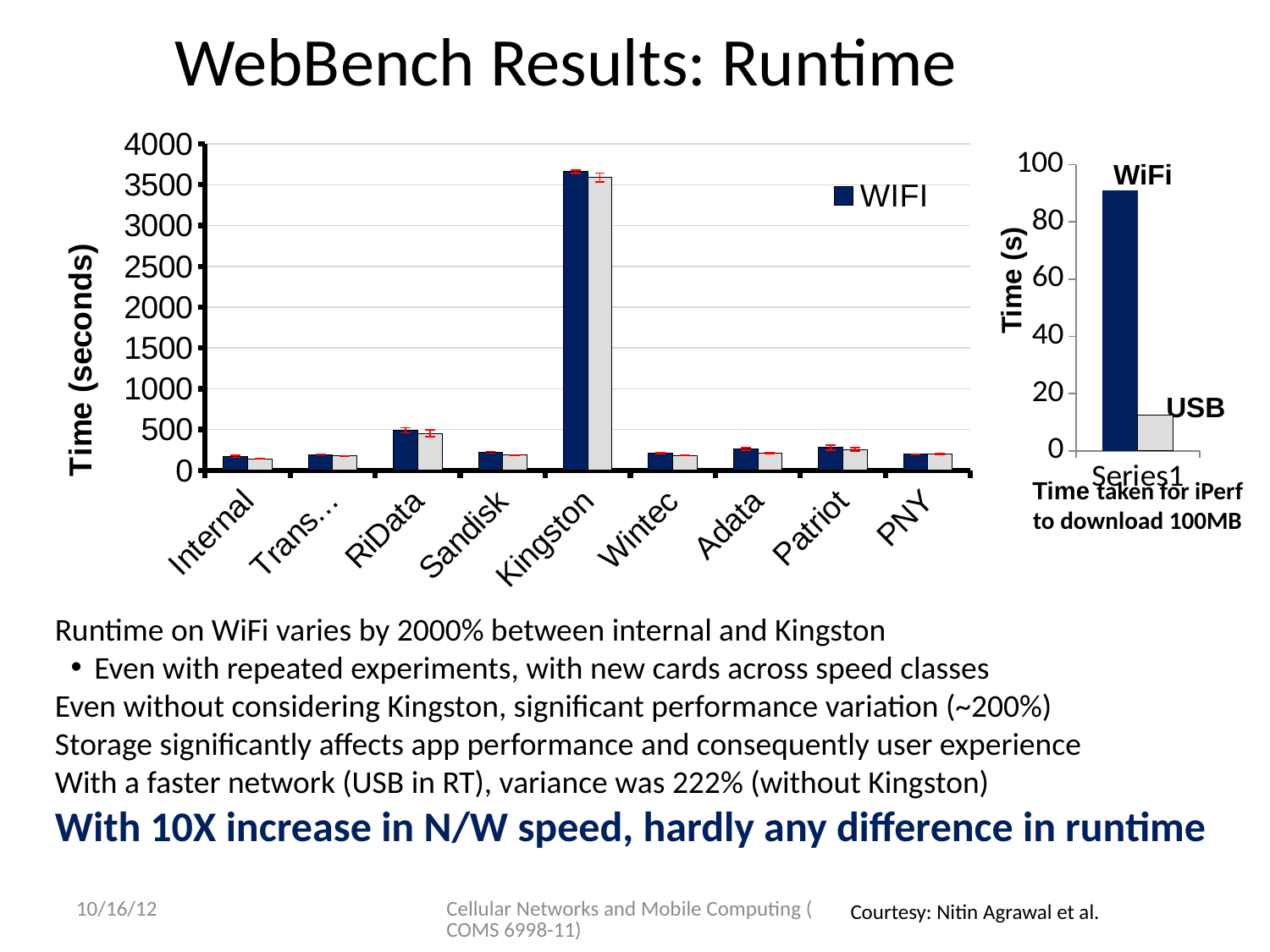
In the left chart, is the WIFI value for Kingston greater or less than 3500? greater What kind of chart is the left chart? bar chart In the right chart (Time taken for iPerf to download 100MB), is the value for WiFi greater or less than 80? greater In the left chart, which category has the highest runtime? Kingston In the left chart, is the WIFI value for Internal greater or less than 500? less In the left chart, which has a larger WIFI runtime, RiData or Sandisk? RiData How many series does the legend of the left chart list? 1 In the right chart (Time taken for iPerf to download 100MB), which bar is higher, WiFi or USB? WiFi What is the y-axis label of the left chart? Time (seconds) How many categories are shown on the x axis of the left chart? 9